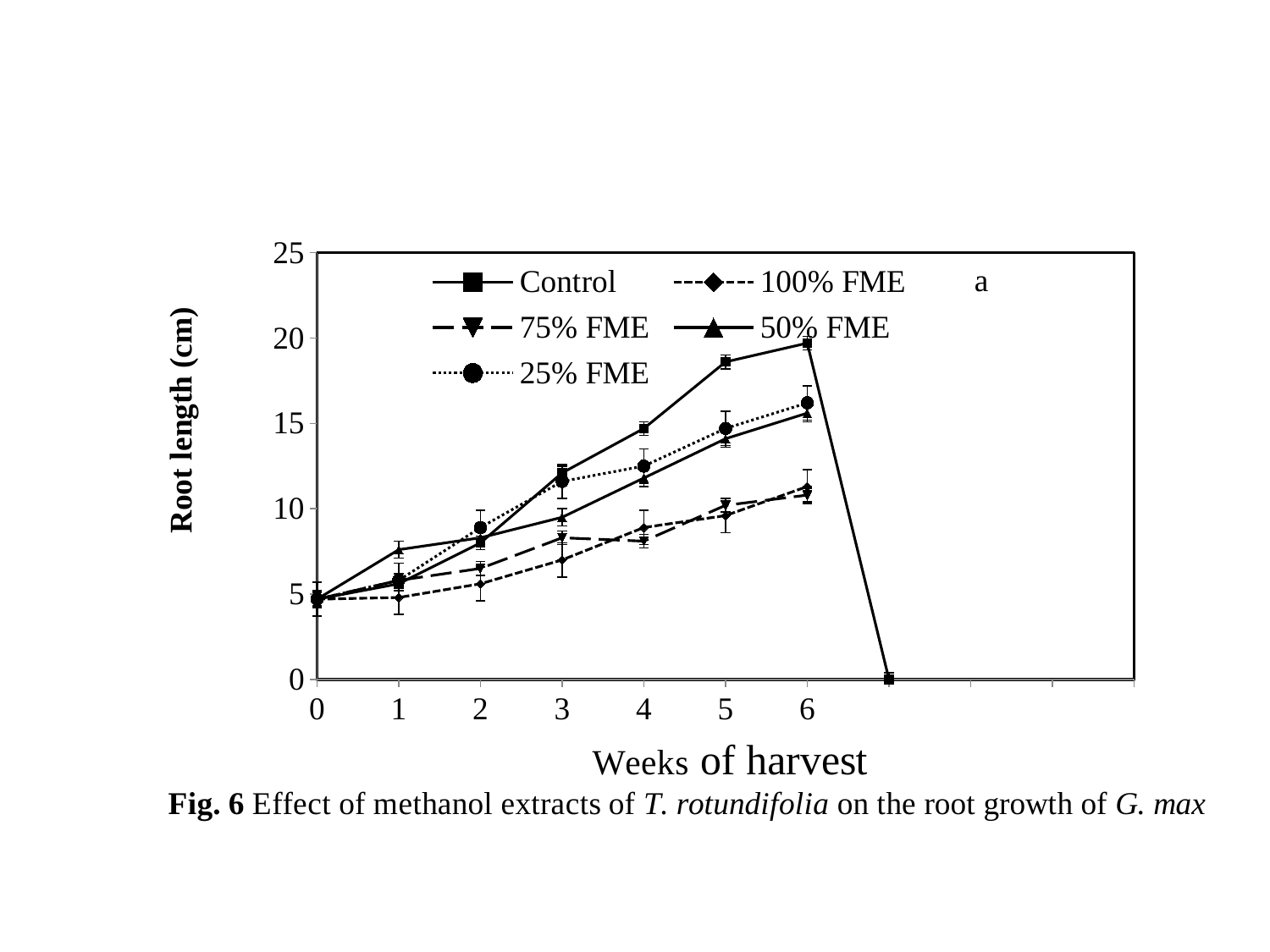
What is the title of the x axis? Weeks of harvest At week 5, which has the larger root length, Control or 75% FME? Control Is the root length for Control at week 6 greater or less than 15? greater At week 4, which has the larger root length, 50% FME or 100% FME? 50% FME What kind of chart is shown on the slide? line chart Which series has the highest root length at week 6? Control What is the title of the y axis? Root length (cm) Which series has the lowest root length at week 3? 100% FME Is the root length for 25% FME at week 6 greater or less than 15? greater Does the root length for Control rise or fall from week 0 to week 6? rise Is the root length for 100% FME at week 3 greater or less than 10? less How many series does the legend list? 5